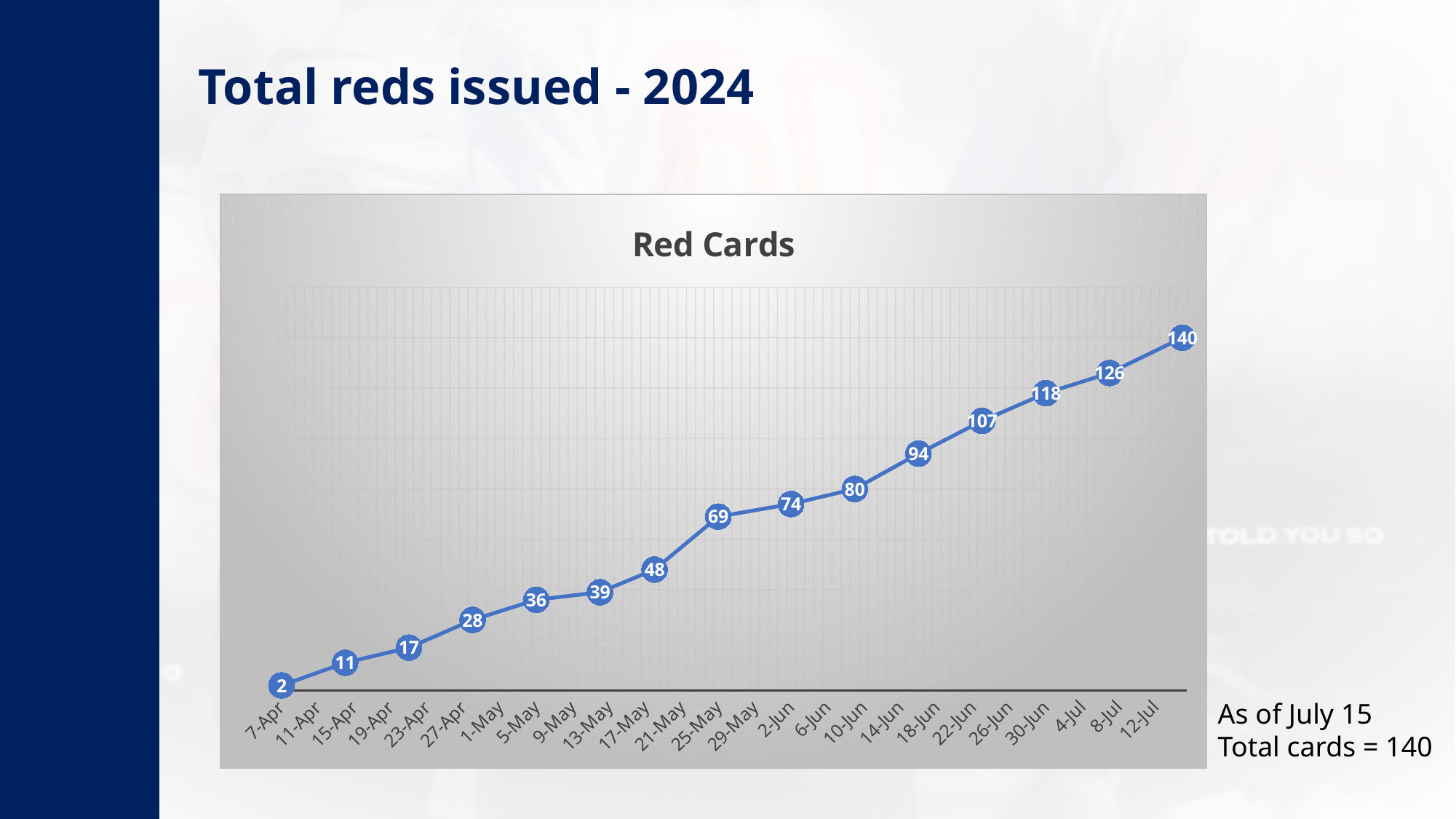
Do the values rise or fall from left to right along the x axis? rise What kind of chart is shown on the slide? line chart What is the highest value plotted on the chart? 140 According to the note beside the chart, what is the total number of cards as of July 15? 140 What value is plotted immediately after the point labelled 48? 69 What is the difference between the points labelled 107 and 94? 13 What is the value of the last data point on the line? 140 How many data points are plotted on the line? 15 What is the title of the chart? Red Cards What is the lowest value plotted on the chart? 2 What is the value of the first data point on the line? 2 What is the difference between the last plotted value and the first plotted value? 138